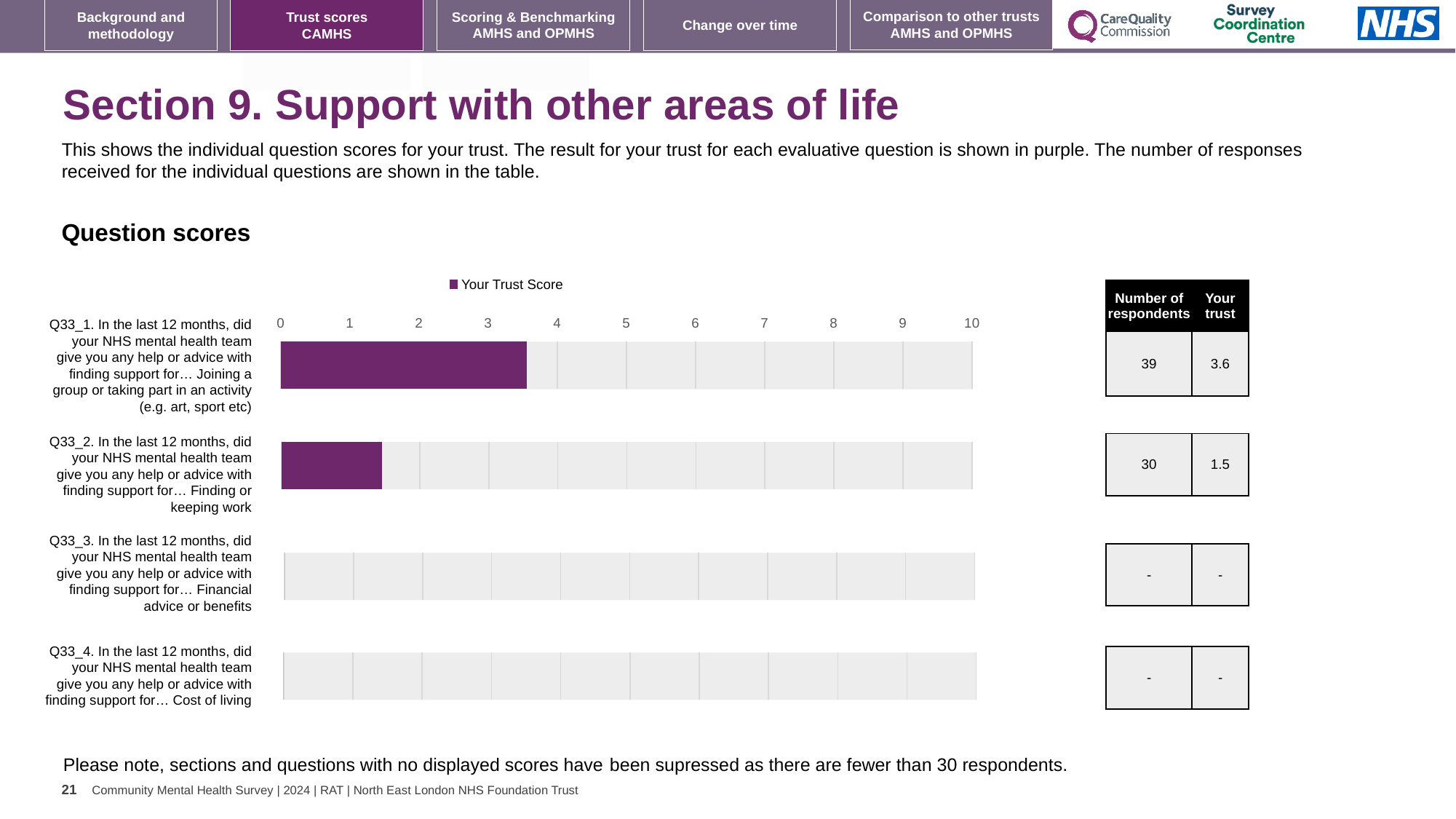
Which has a larger Your Trust Score, Q33_1 or Q33_2? Q33_1 How many series does the chart legend list? 1 What is the Your Trust Score for Q33_1 (finding support for joining a group or taking part in an activity)? 3.6 How many respondents answered Q33_2? 30 Is the Your Trust Score for Q33_2 greater or less than 2? less What type of chart is shown on the slide? Bar chart How many questions (categories) are listed on the chart? 4 What is the Your Trust Score for Q33_2 (finding support for finding or keeping work)? 1.5 What is the difference between the Your Trust Score for Q33_1 and Q33_2? 2.1 How many respondents answered Q33_1? 39 Which question has the highest Your Trust Score on the chart? Q33_1 Is the Your Trust Score for Q33_1 greater or less than 3? greater